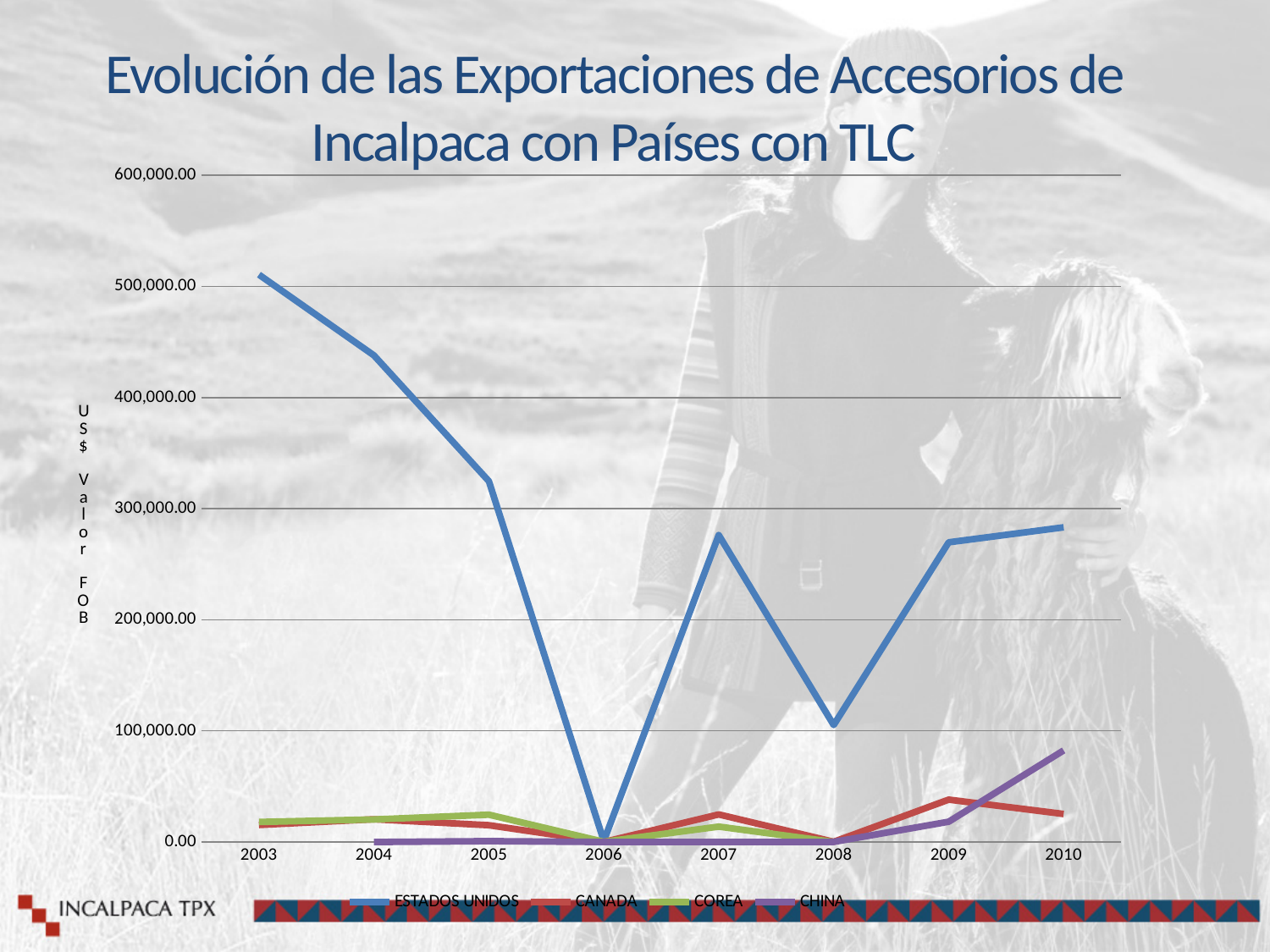
What kind of chart is shown on the slide? line chart In which year does the ESTADOS UNIDOS series reach its highest value? 2003 What is the label on the vertical axis of the chart? US$ Valor FOB Is the value for ESTADOS UNIDOS in 2007 greater or less than 300,000.00? less Which series has the highest value in 2010? ESTADOS UNIDOS In which year does the ESTADOS UNIDOS series reach its lowest value? 2006 How many years are shown along the x axis? 8 Is the value for ESTADOS UNIDOS in 2004 greater or less than 400,000.00? greater Does the ESTADOS UNIDOS series rise or fall from 2003 to 2006? fall How many series does the legend list? 4 Which is larger for ESTADOS UNIDOS: the value in 2008 or the value in 2009? 2009 Is the value for CHINA in 2010 greater or less than 100,000.00? less